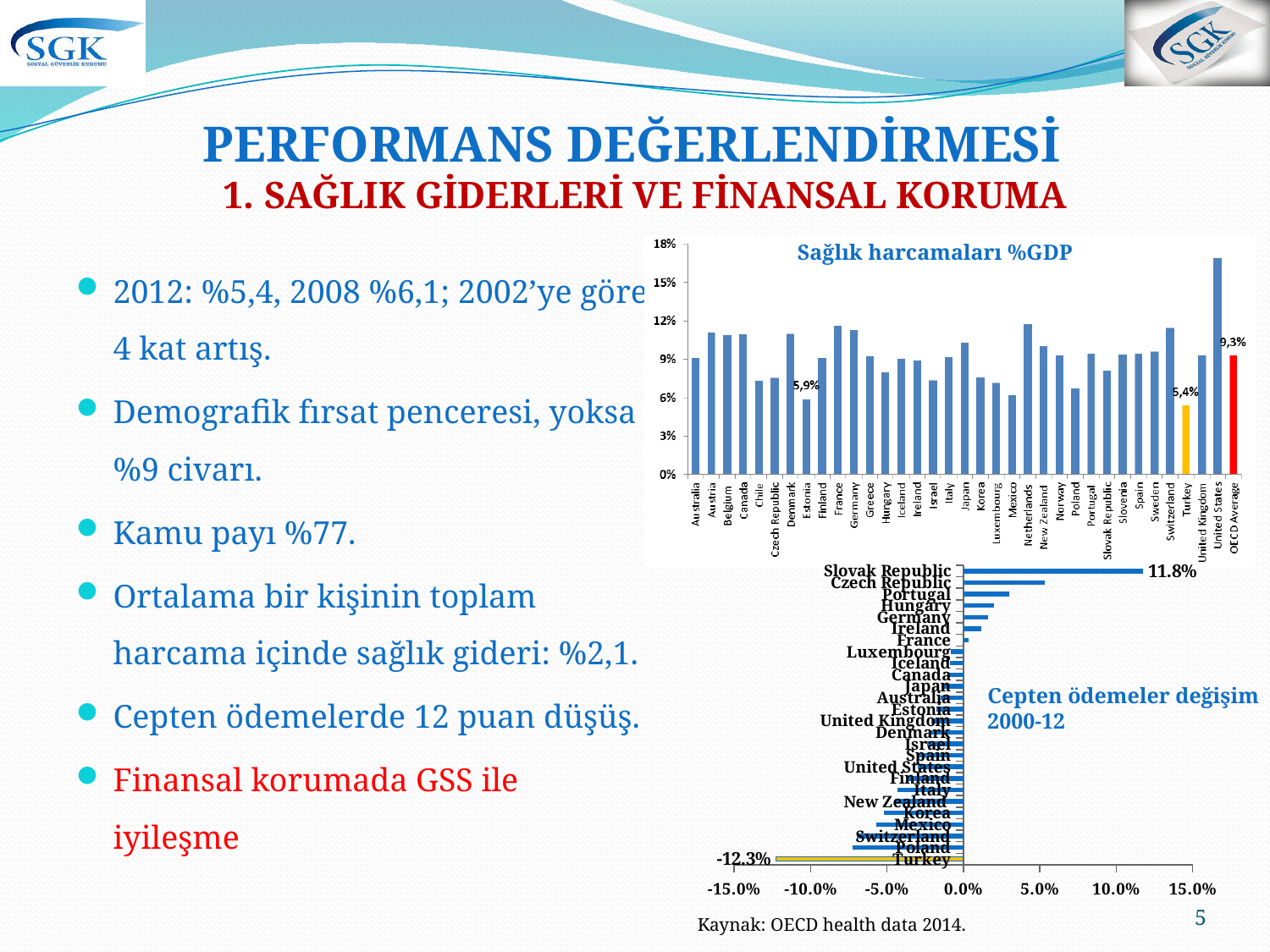
In the 'Sağlık harcamaları %GDP' chart, is the value for United States greater or less than 15%? greater In the 'Sağlık harcamaları %GDP' chart, what is the difference between the OECD Average and Turkey? 3,9% In the 'Cepten ödemeler değişim 2000-12' chart, which country has the lowest value? Turkey In the 'Cepten ödemeler değişim 2000-12' chart, what is the value for Slovak Republic? 11.8% In the 'Sağlık harcamaları %GDP' chart, what is the value for Estonia? 5,9% What kind of chart is the 'Sağlık harcamaları %GDP' chart? bar chart In the 'Sağlık harcamaları %GDP' chart, is the value for Mexico greater or less than 9%? less In the 'Sağlık harcamaları %GDP' chart, what is the value for OECD Average? 9,3% In the 'Sağlık harcamaları %GDP' chart, which is larger, the value for Turkey or the value for Estonia? Estonia In the 'Sağlık harcamaları %GDP' chart, which country has the highest value? United States In the 'Cepten ödemeler değişim 2000-12' chart, what is the value for Turkey? -12.3% In the 'Sağlık harcamaları %GDP' chart, what is the value for Turkey? 5,4%